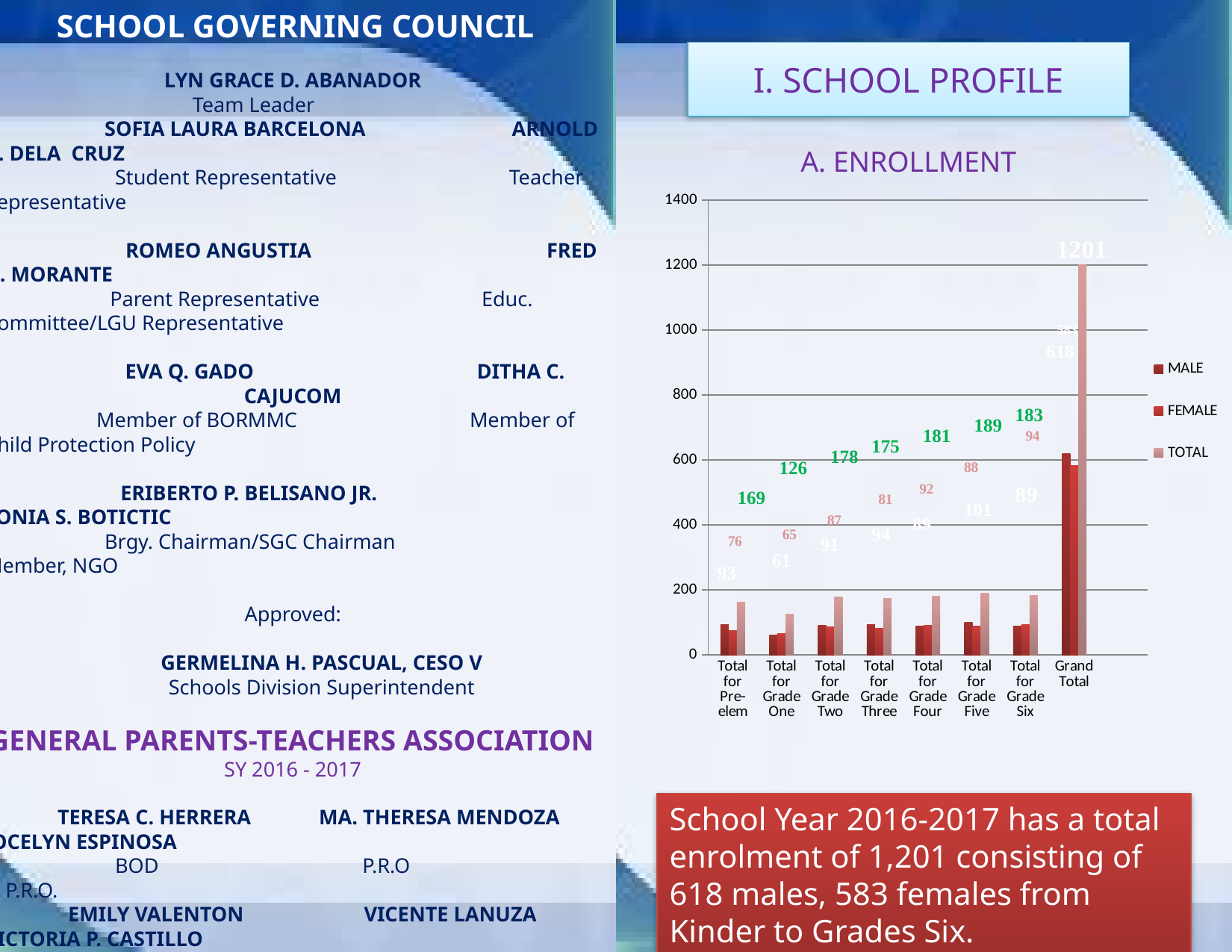
What is the TOTAL value for Total for Grade Two in the enrollment chart? 178 Which grade level has the lowest TOTAL in the enrollment chart? Total for Grade One How many series does the legend of the enrollment chart list? 3 What is the MALE value for Total for Grade Five in the enrollment chart? 101 Excluding Grand Total, which grade level has the highest TOTAL in the enrollment chart? Total for Grade Five Is the TOTAL value for Grand Total in the enrollment chart greater or less than 1000? greater What is the TOTAL value for Grand Total in the enrollment chart? 1201 What is the difference between the TOTAL for Grade Five and the TOTAL for Grade One in the enrollment chart? 63 In the enrollment chart, is the MALE or the FEMALE value larger for Total for Grade Four? FEMALE How many categories are shown on the x axis of the enrollment chart? 8 What is the FEMALE value for Total for Pre-elem in the enrollment chart? 76 What kind of chart is shown under A. ENROLLMENT? bar chart